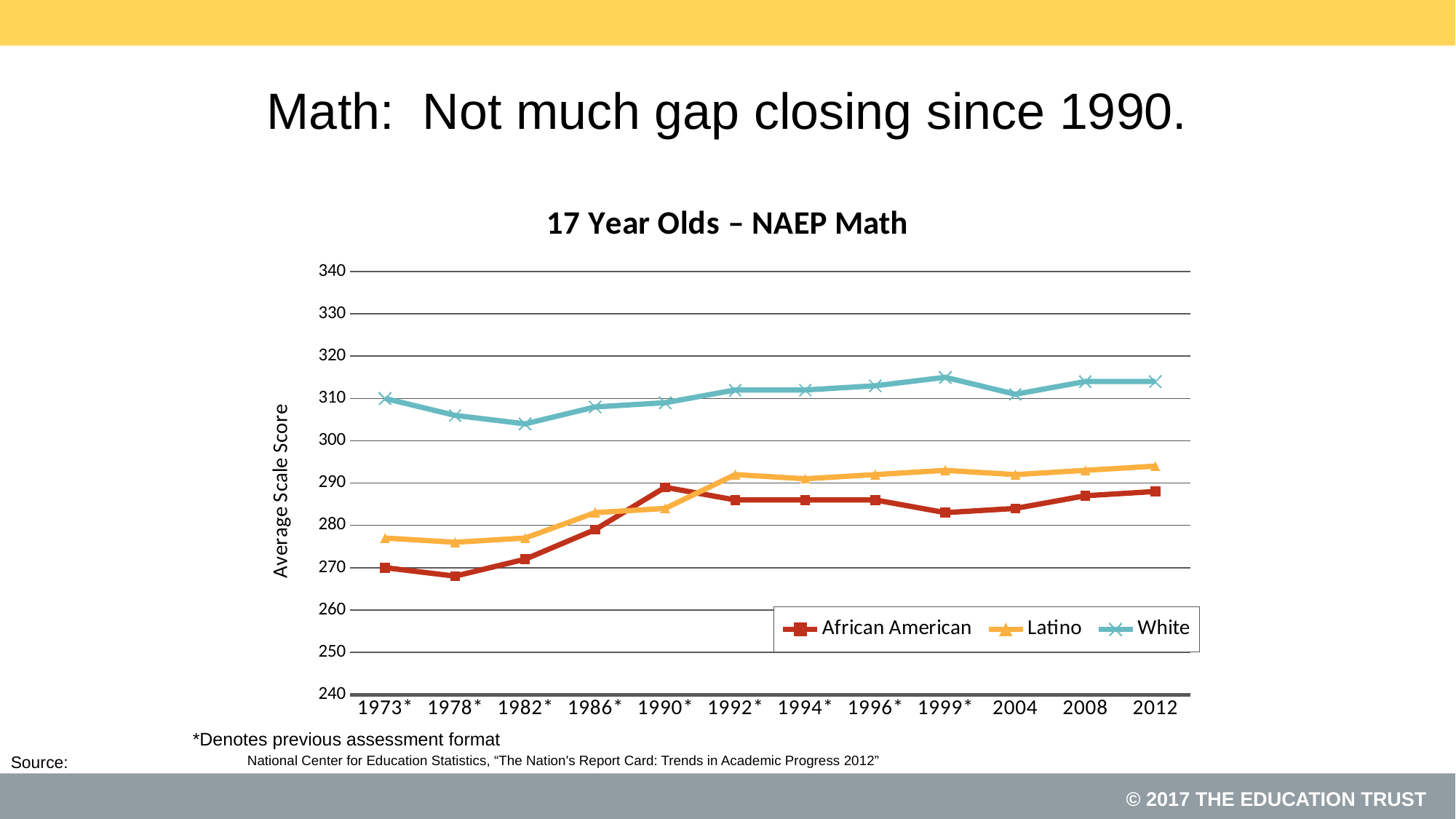
In 1973*, which is larger, the Latino score or the African American score? Latino Does the African American score rise or fall from 1973* to 1990*? rise How many series does the legend list? 3 Which group has the highest score in 2012? White What kind of chart is shown on the slide? line chart How many years are shown along the x axis? 12 Is the Latino score in 2012 greater or less than 300? less Is the African American score in 1999* greater or less than 280? greater What is the label on the vertical axis? Average Scale Score What is the title of the chart? 17 Year Olds – NAEP Math Which group has the lowest score in 1973*? African American Is the White score in 1982* greater or less than 310? less